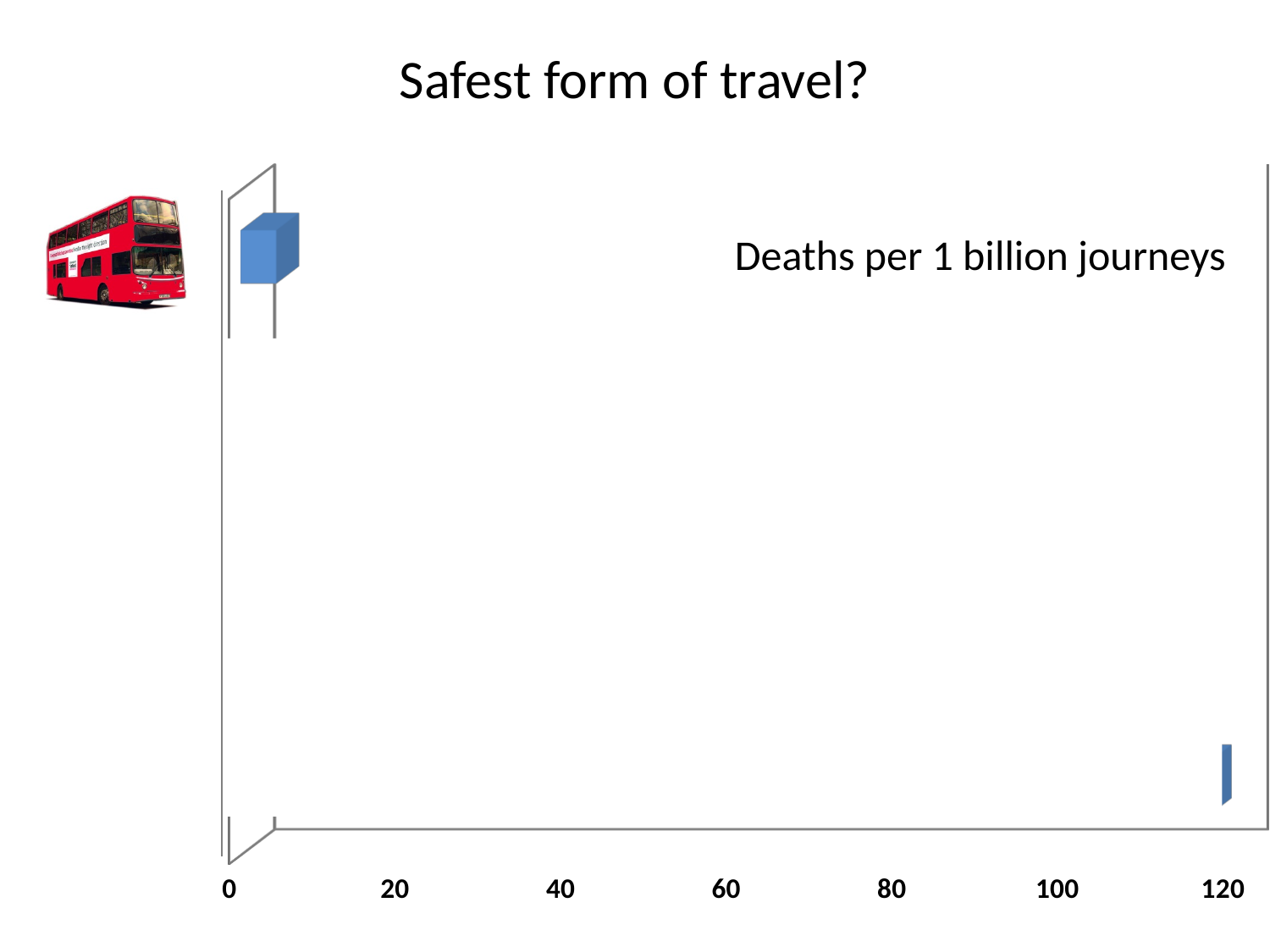
Is the value of the bar next to the bus image greater or less than 20? less What kind of chart is shown on the slide? bar chart What quantity does the chart measure, according to the text on the slide? Deaths per 1 billion journeys What is the highest value shown on the horizontal axis? 120 Is the value of the bar next to the bus image greater or less than 40? less What is the title of the slide? Safest form of travel?